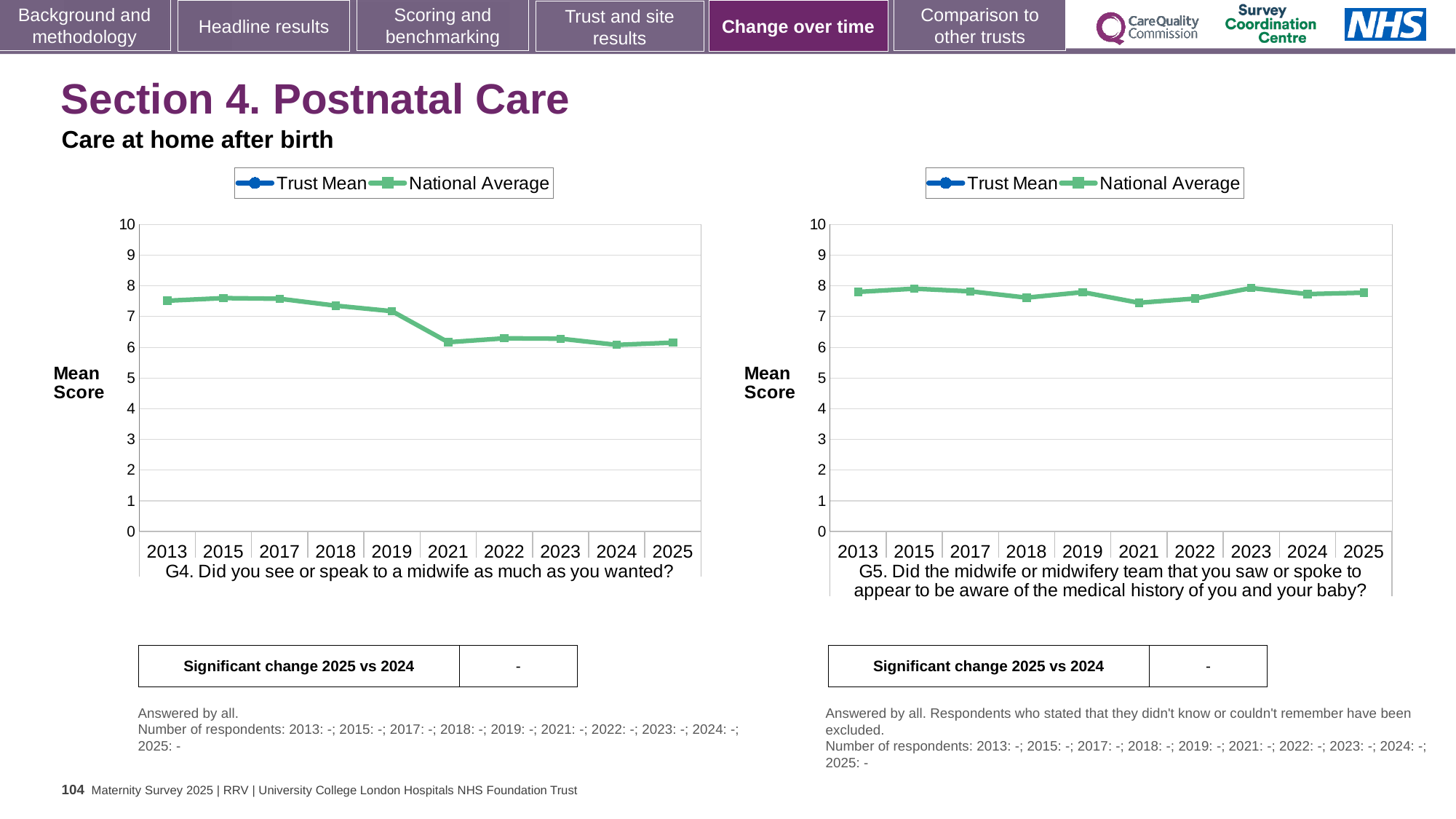
In the left chart (G4), is the National Average value for 2013 greater or less than 7? greater How many years are shown on the x axis of the left chart (G4)? 10 What kind of chart is the left chart (G4)? line chart In the left chart (G4), is the National Average value for 2013 larger or smaller than the value for 2025? larger In the right chart (G5), is the National Average value for 2013 greater or less than 7? greater How many series does the legend of the right chart (G5) list? 2 What are the two legend entries of the left chart (G4)? Trust Mean and National Average In the left chart (G4), does the National Average line overall rise or fall from 2013 to 2025? fall What is the first year shown on the x axis of the right chart (G5)? 2013 In the left chart (G4), is the National Average value for 2024 greater or less than 7? less